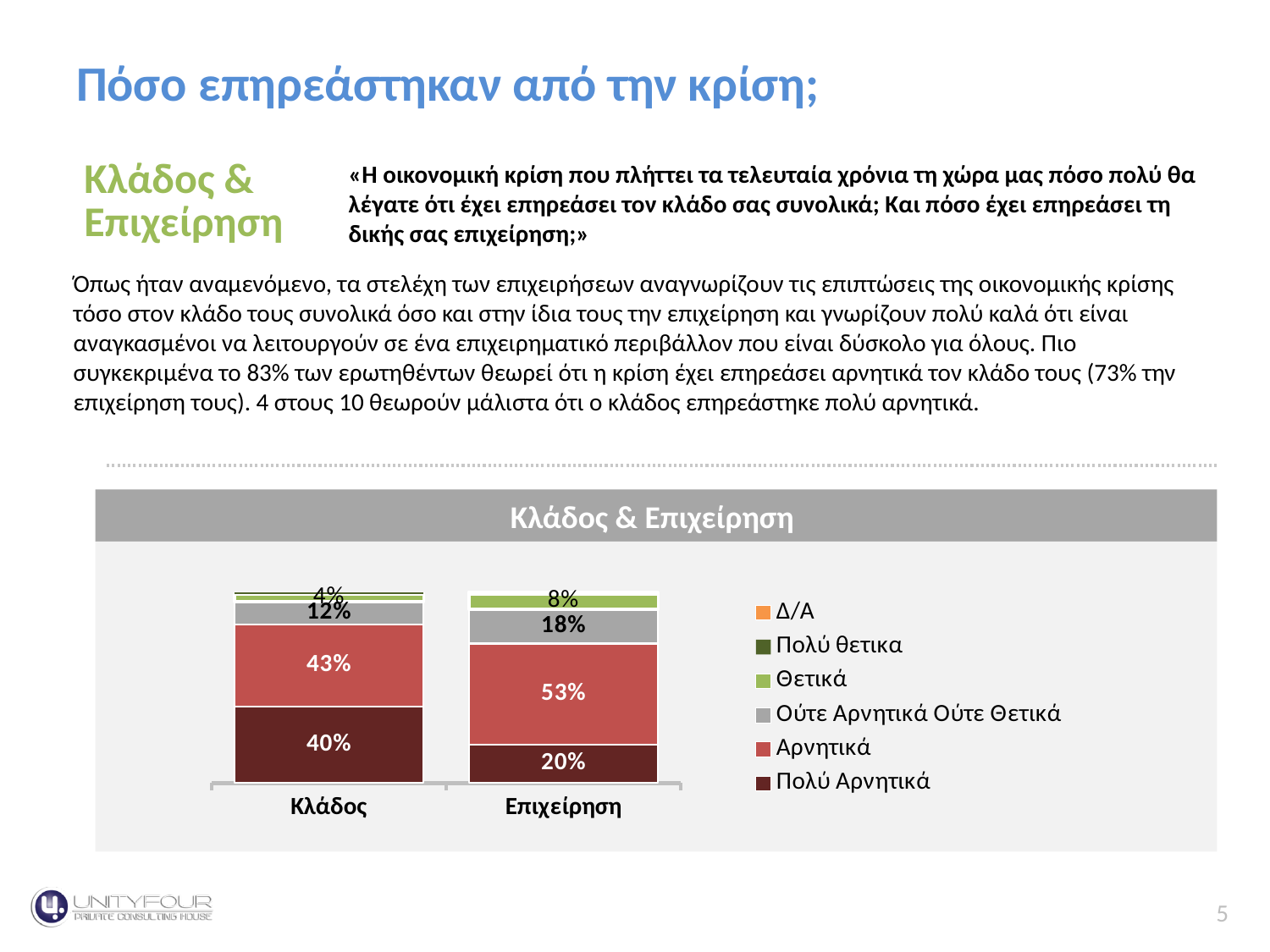
Which category has the larger Πολύ Αρνητικά value, Κλάδος or Επιχείρηση? Κλάδος What is the value of Αρνητικά for Κλάδος? 43% How many series does the legend of the chart list? 6 What is the difference between the Αρνητικά values for Επιχείρηση and Κλάδος? 10% What is the value of Πολύ Αρνητικά for Κλάδος? 40% What is the value of Θετικά for Επιχείρηση? 8% What is the difference between the Πολύ Αρνητικά values for Κλάδος and Επιχείρηση? 20% What kind of chart is shown on the slide? stacked bar chart What is the value of Αρνητικά for Επιχείρηση? 53% How many categories are shown on the x axis of the chart? 2 What is the title of the chart? Κλάδος & Επιχείρηση What is the value of Ούτε Αρνητικά Ούτε Θετικά for Επιχείρηση? 18%